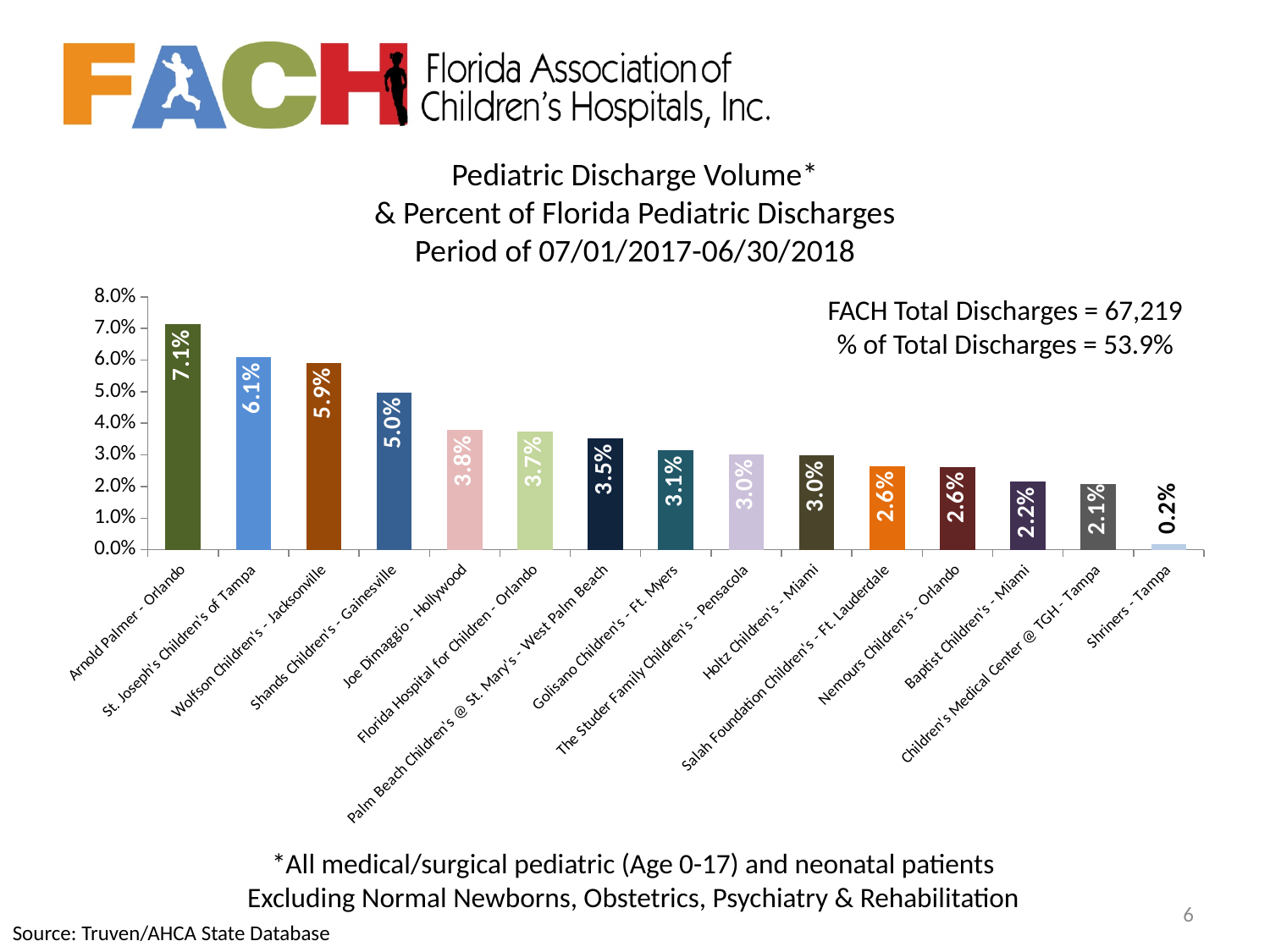
What percent of Florida pediatric discharges is shown for Arnold Palmer - Orlando? 7.1% What value is shown for Golisano Children's - Ft. Myers? 3.1% Do the values rise or fall moving from left to right across the chart? Fall How many hospitals are shown on the chart? 15 What is the difference between the values for Arnold Palmer - Orlando and St. Joseph's Children's of Tampa? 1.0% What is the FACH Total Discharges figure stated on the chart? 67,219 Which is larger, the value for Shands Children's - Gainesville or the value for Joe Dimaggio - Hollywood? Shands Children's - Gainesville Which hospital has the highest percent of Florida pediatric discharges? Arnold Palmer - Orlando What kind of chart is shown on the slide? Bar chart What value is shown for Wolfson Children's - Jacksonville? 5.9% Which hospital has the lowest percent of Florida pediatric discharges? Shriners - Tampa What value is shown for Shriners - Tampa? 0.2%